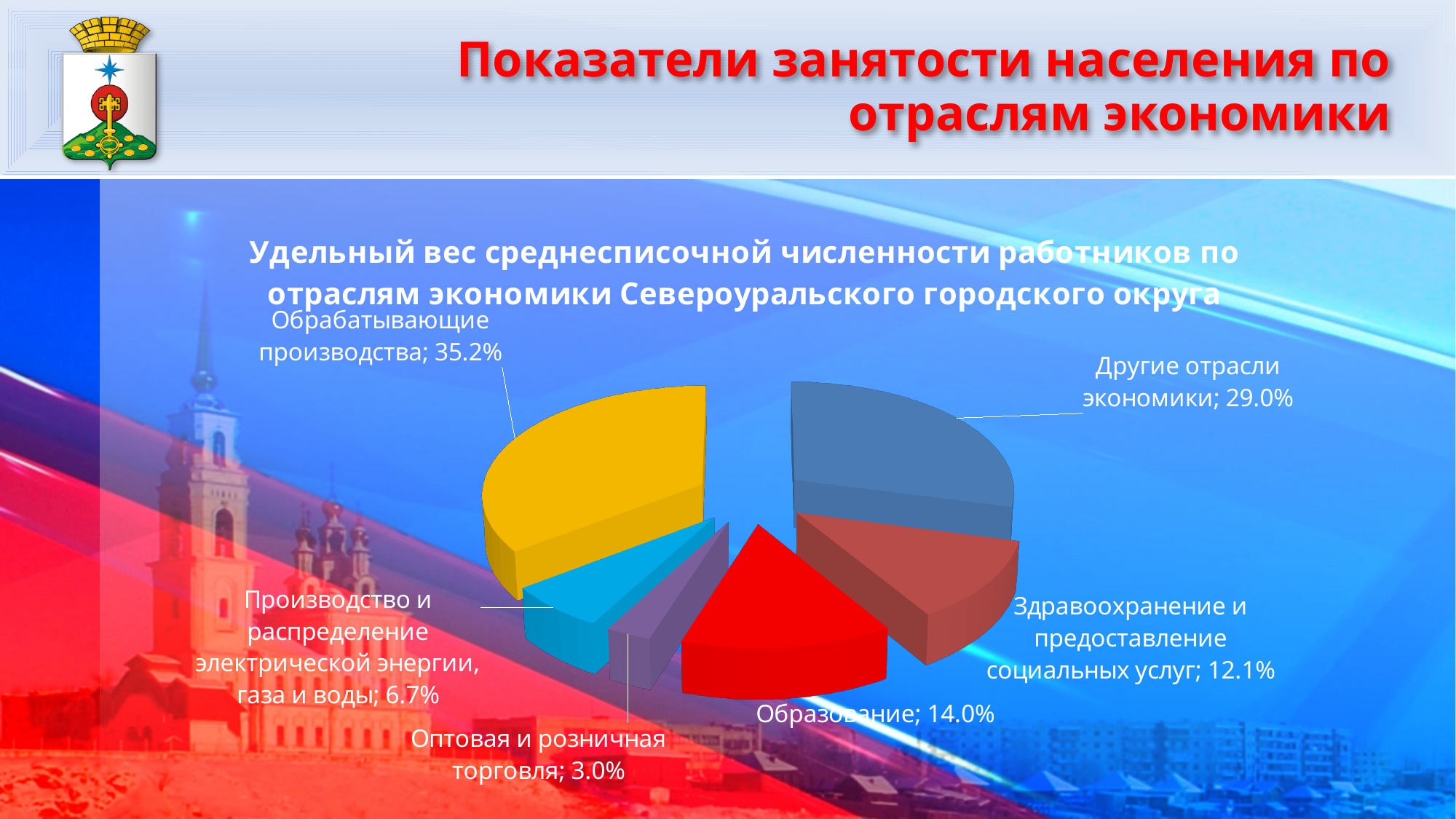
Which sector has the largest share of the pie? Обрабатывающие производства Which is larger: the share for Образование or the share for Здравоохранение и предоставление социальных услуг? Образование What is the share for Образование? 14.0% How many slices does the pie chart have? 6 What type of chart is shown on the slide? Pie chart What is the share for Производство и распределение электрической энергии, газа и воды? 6.7% What is the share for Здравоохранение и предоставление социальных услуг? 12.1% What is the share for Другие отрасли экономики? 29.0% What is the share for Обрабатывающие производства? 35.2% What is the difference in percentage points between Обрабатывающие производства and Другие отрасли экономики? 6.2 Which sector has the smallest share of the pie? Оптовая и розничная торговля What is the share for Оптовая и розничная торговля? 3.0%